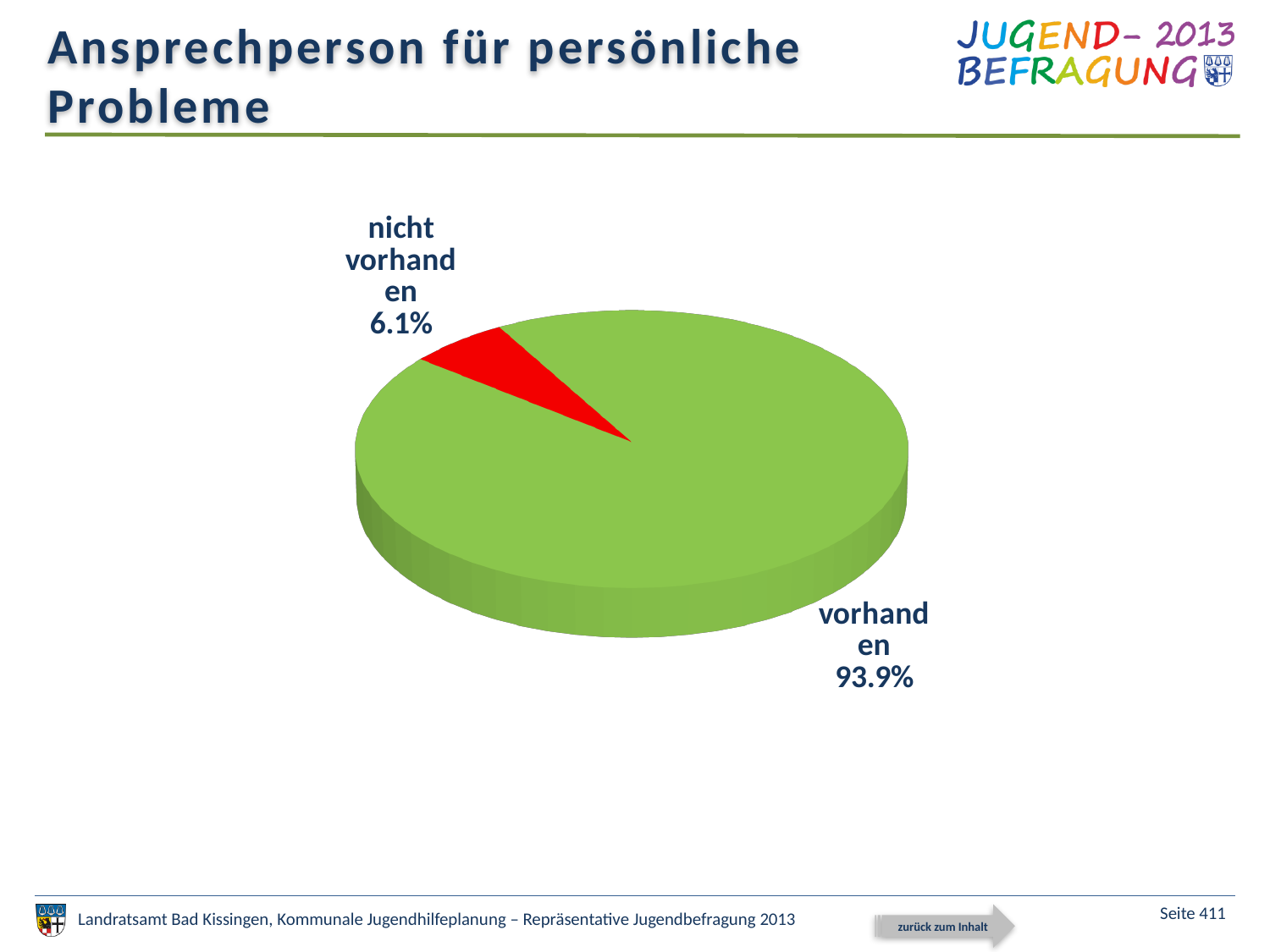
What kind of chart is shown on the slide? pie chart Which is larger, the "vorhanden" slice or the "nicht vorhanden" slice? vorhanden What share of the pie is labelled "vorhanden"? 93.9% What share of the pie is labelled "nicht vorhanden"? 6.1% What colour is the "nicht vorhanden" slice? red What is the total of the two slice percentages shown? 100% Which slice of the pie is the smallest? nicht vorhanden What is the difference in percentage points between the "vorhanden" and "nicht vorhanden" slices? 87.8 What is the title of the slide containing the chart? Ansprechperson für persönliche Probleme Which slice of the pie is the largest? vorhanden How many slices does the pie chart have? 2